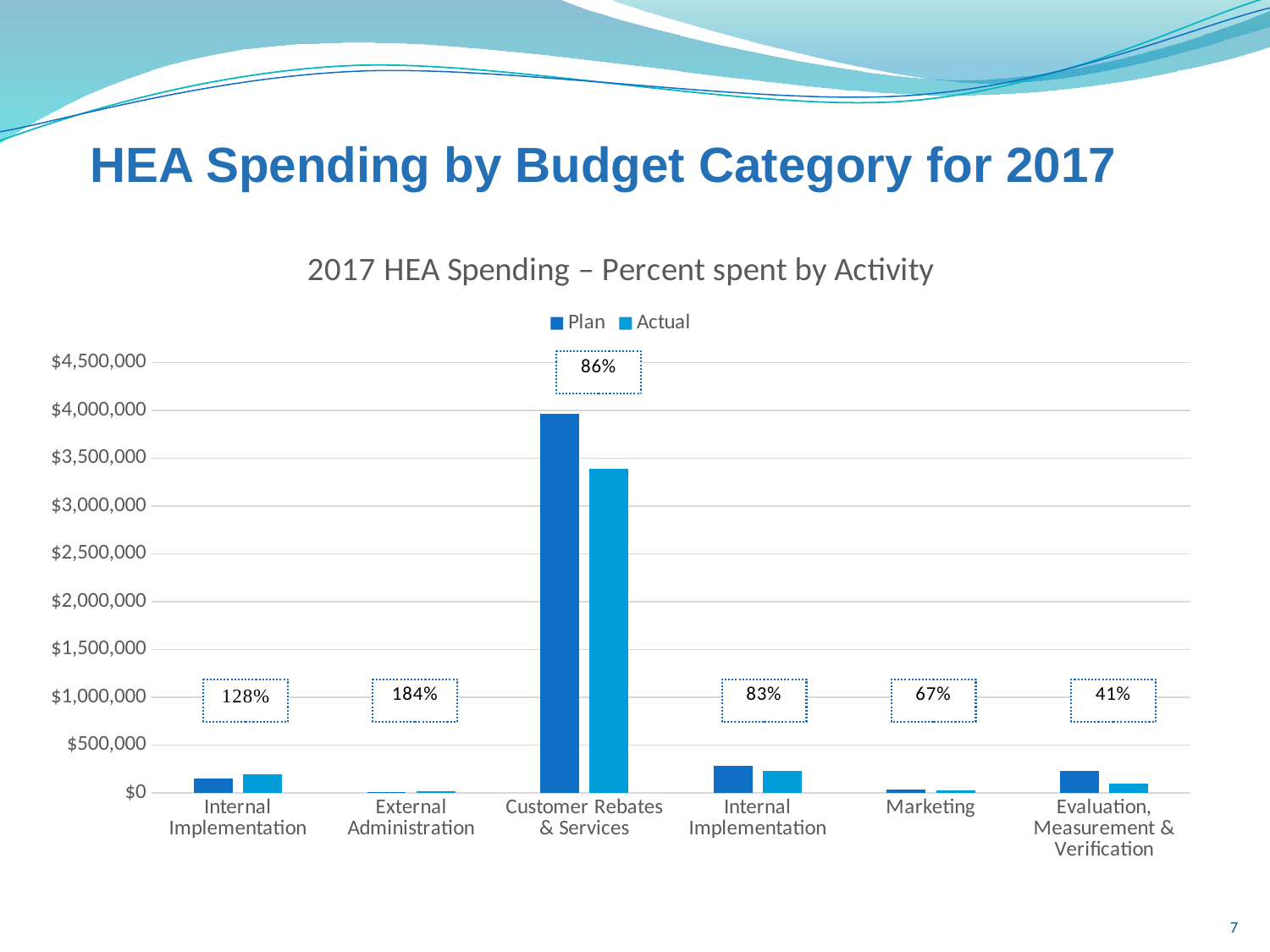
How many budget categories are shown on the x axis? 6 What are the two series named in the legend? Plan and Actual Which category has the highest Plan value? Customer Rebates & Services What percentage label is shown above the Customer Rebates & Services bars? 86% What is the title of the chart? 2017 HEA Spending – Percent spent by Activity What type of chart is shown on the slide? bar chart Is the Plan value for Customer Rebates & Services greater or less than $3,500,000? greater How many series does the chart legend list? 2 Is the Actual value for Customer Rebates & Services greater or less than $3,000,000? greater For Customer Rebates & Services, which is larger, the Plan value or the Actual value? Plan Which category has the highest Actual value? Customer Rebates & Services Is the Plan value for Marketing greater or less than $500,000? less